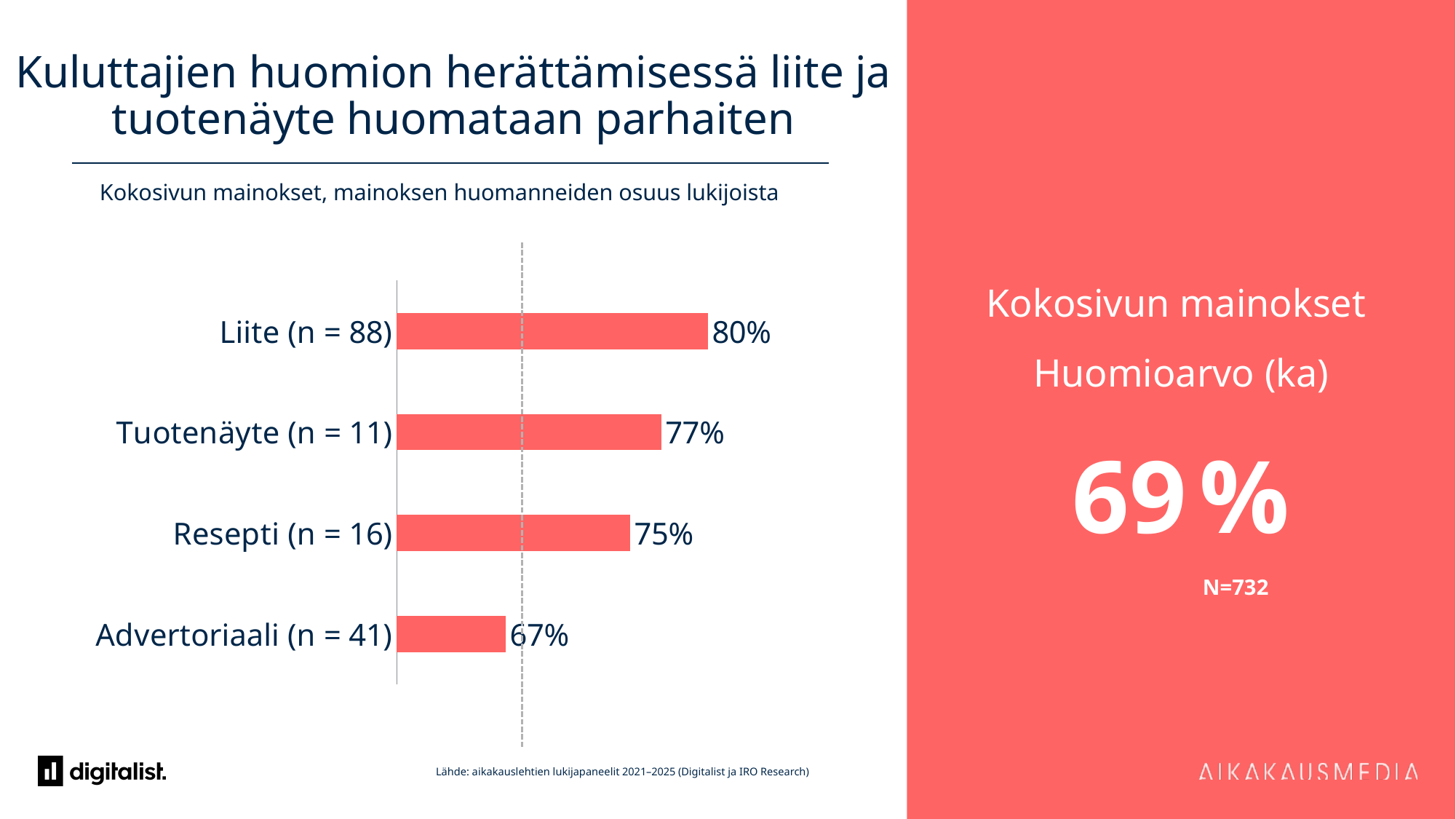
Which is larger, the value for Liite (n = 88) or the value for Resepti (n = 16)? Liite (n = 88) What is the value for Resepti (n = 16)? 75% How many categories does the chart show? 4 What is the average attention value (Huomioarvo) shown for Kokosivun mainokset on the right panel? 69 % Which category has the lowest value? Advertoriaali (n = 41) What is the difference between the values for Tuotenäyte (n = 11) and Resepti (n = 16)? 2 percentage points What kind of chart is shown on the slide? Bar chart What is the value for Tuotenäyte (n = 11)? 77% What is the difference between the values for Liite (n = 88) and Advertoriaali (n = 41)? 13 percentage points What is the value for Advertoriaali (n = 41)? 67% What is the value for Liite (n = 88)? 80% Which category has the highest value? Liite (n = 88)